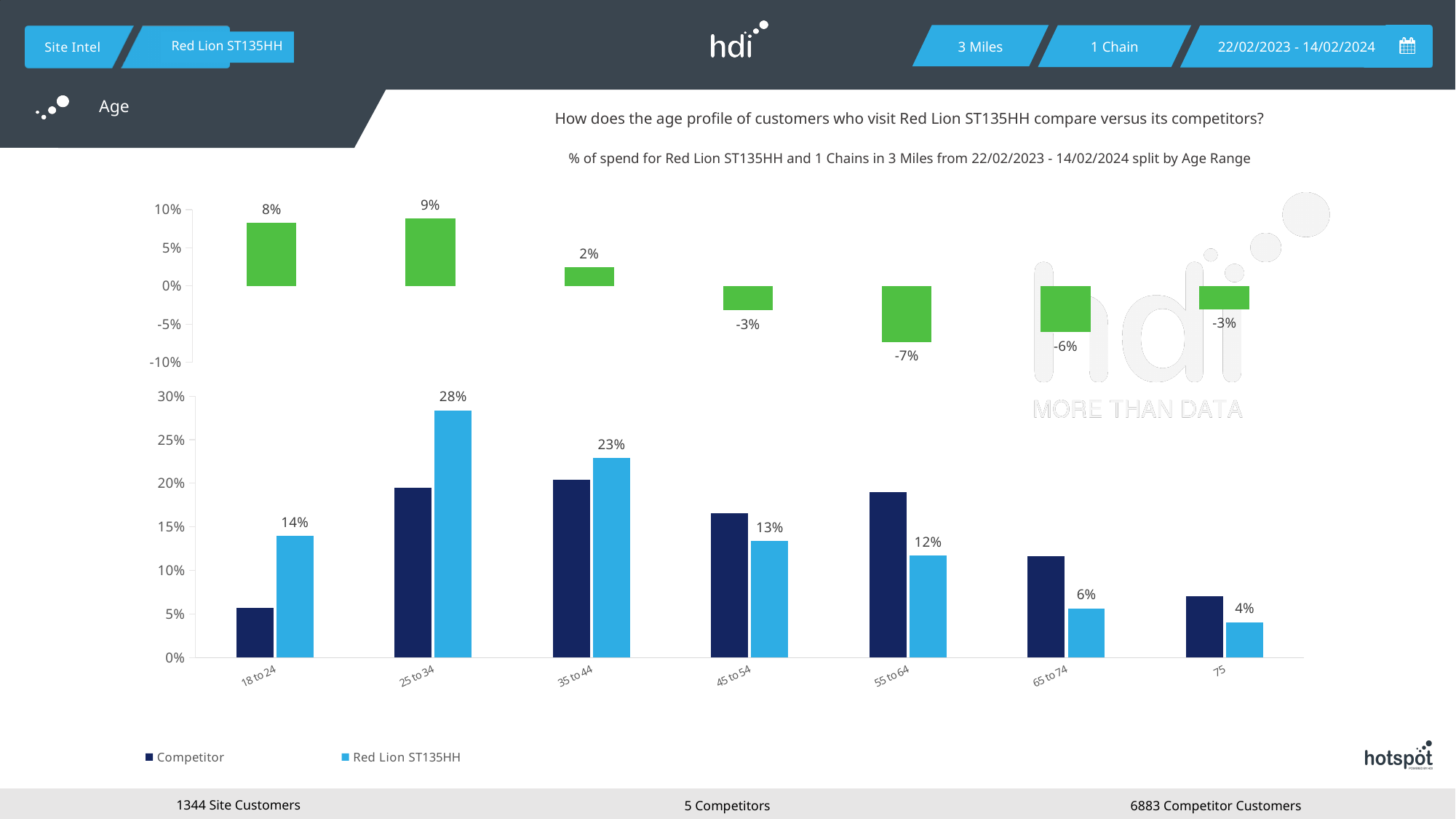
In the bottom chart, what is the value for Red Lion ST135HH in the 25 to 34 age range? 28% How many series does the legend of the bottom chart list? 2 In the bottom chart, what is the difference between the Red Lion ST135HH values for 25 to 34 and 35 to 44? 5% In the bottom chart, which age range has the highest value for Red Lion ST135HH? 25 to 34 In the bottom chart, is the Competitor value for 55 to 64 greater or less than 15%? greater In the bottom chart, for the 18 to 24 age range, which series has the larger value: Competitor or Red Lion ST135HH? Red Lion ST135HH How many age range categories are shown on the x axis of the bottom chart? 7 In the bottom chart, is the Competitor value for 18 to 24 greater or less than 10%? less What kind of chart is the bottom chart? bar chart In the bottom chart, which age range has the lowest value for Red Lion ST135HH? 75 In the bottom chart, what is the value for Red Lion ST135HH in the 75 age range? 4% In the top chart, what is the value shown for the 55 to 64 age range? -7%